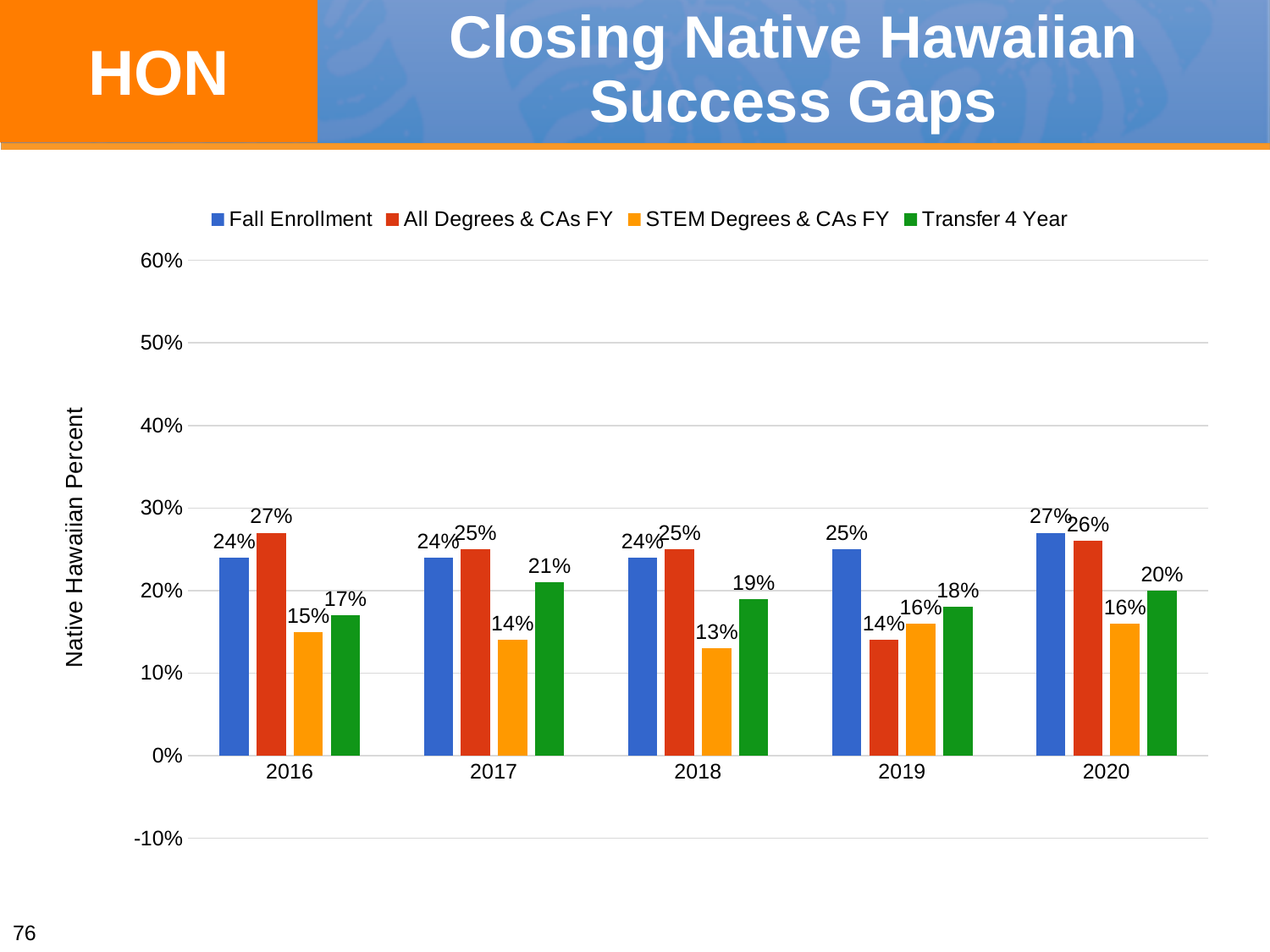
What is the difference between the All Degrees & CAs FY value and the STEM Degrees & CAs FY value in 2016? 12% What is the Transfer 4 Year value for 2017? 21% What kind of chart is shown on the slide? Bar chart How many years are shown on the x axis? 5 In which year is the Fall Enrollment value highest? 2020 How many series does the legend list? 4 What is the Fall Enrollment value for 2016? 24% What is the label of the vertical axis? Native Hawaiian Percent In 2020, which is larger: Fall Enrollment or All Degrees & CAs FY? Fall Enrollment In which year is the STEM Degrees & CAs FY value lowest? 2018 What is the STEM Degrees & CAs FY value for 2018? 13% What is the All Degrees & CAs FY value for 2019? 14%